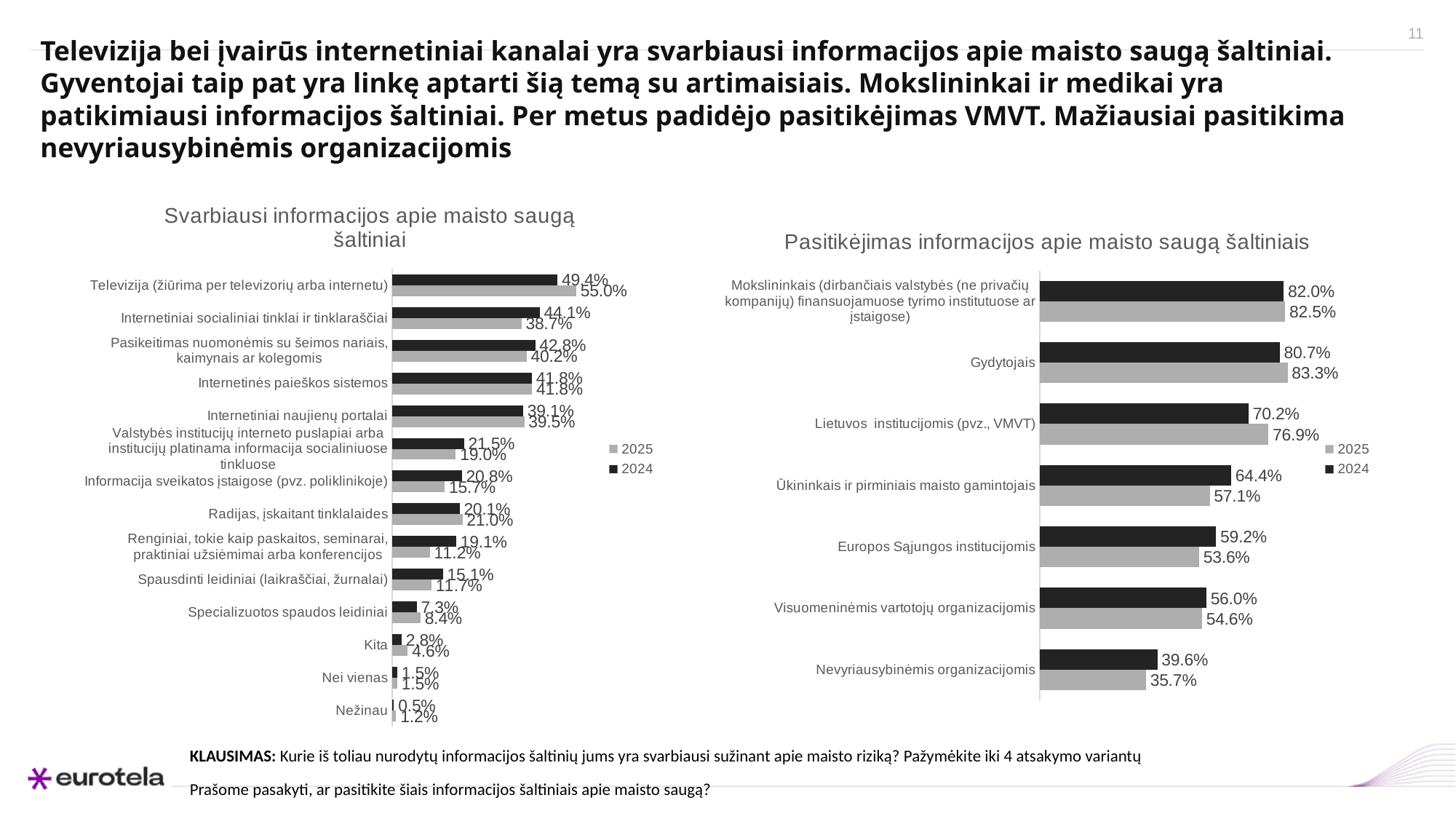
In the chart 'Pasitikėjimas informacijos apie maisto saugą šaltiniais', which category has the lowest 2025 value? Nevyriausybinėmis organizacijomis In the chart 'Pasitikėjimas informacijos apie maisto saugą šaltiniais', what is the 2024 value for Lietuvos institucijomis (pvz., VMVT)? 70.2% In the chart 'Svarbiausi informacijos apie maisto saugą šaltiniai', which category has the highest 2025 value? Televizija (žiūrima per televizorių arba internetu) In the chart 'Pasitikėjimas informacijos apie maisto saugą šaltiniais', what is the difference between the 2025 and 2024 values for Lietuvos institucijomis (pvz., VMVT)? 6.7% How many categories are shown in the chart 'Pasitikėjimas informacijos apie maisto saugą šaltiniais'? 7 How many series does the legend of the chart 'Svarbiausi informacijos apie maisto saugą šaltiniai' list? 2 In the chart 'Svarbiausi informacijos apie maisto saugą šaltiniai', what is the difference between the 2025 and 2024 values for Televizija? 5.6% What kind of chart is 'Pasitikėjimas informacijos apie maisto saugą šaltiniais'? Bar chart In the chart 'Pasitikėjimas informacijos apie maisto saugą šaltiniais', what is the 2025 value for Gydytojais? 83.3% In the chart 'Svarbiausi informacijos apie maisto saugą šaltiniai', what is the 2024 value for Televizija (žiūrima per televizorių arba internetu)? 49.4% In the chart 'Svarbiausi informacijos apie maisto saugą šaltiniai', which is larger for Renginiai, tokie kaip paskaitos, seminarai, praktiniai užsiėmimai arba konferencijos: the 2024 value or the 2025 value? 2024 In the chart 'Pasitikėjimas informacijos apie maisto saugą šaltiniais', which is larger for Ūkininkais ir pirminiais maisto gamintojais: the 2024 value or the 2025 value? 2024